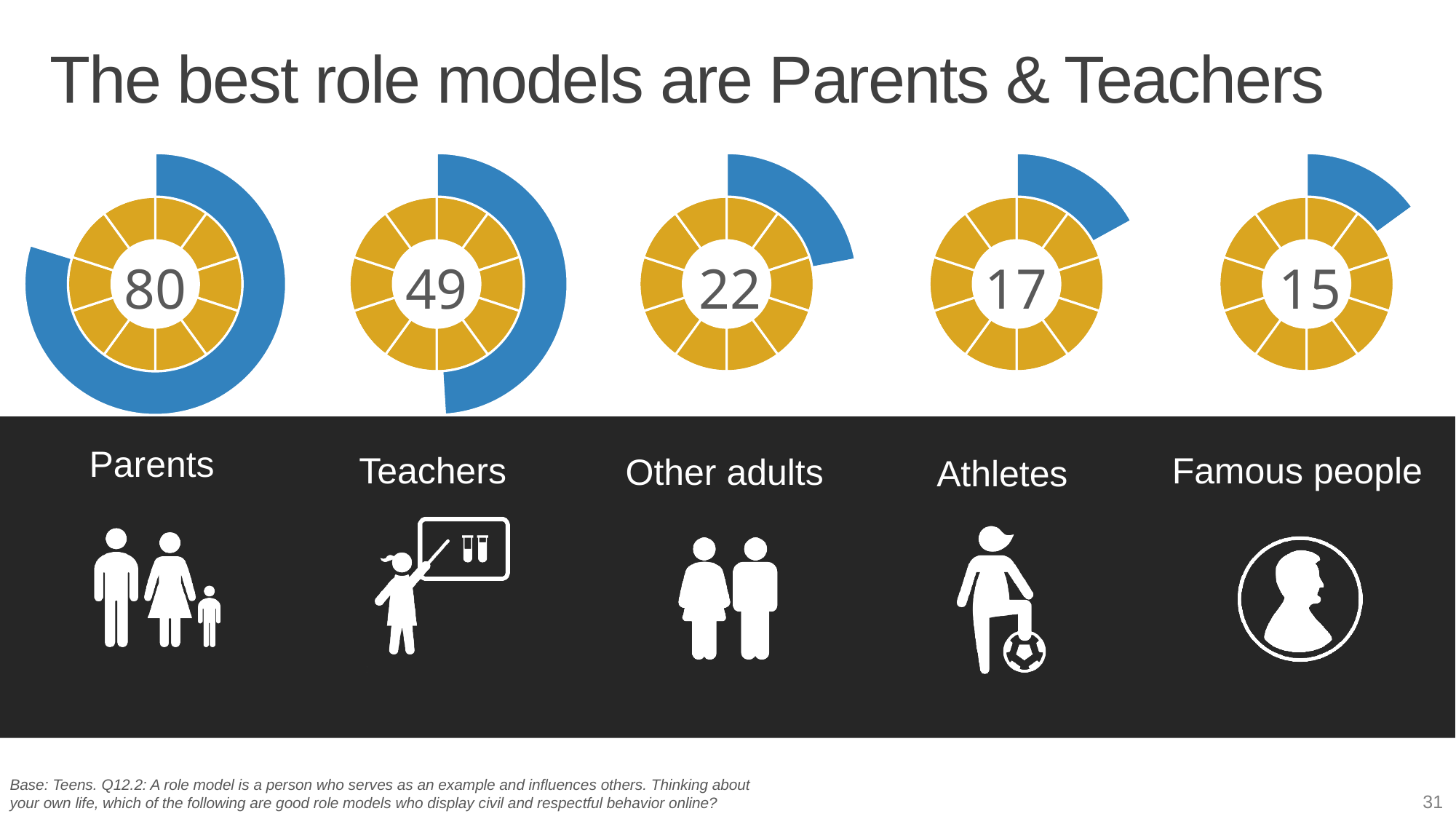
How many role model categories are shown on the slide? 5 What is the value shown for Famous people? 15 What is the value shown for Parents? 80 Which category has the lowest value? Famous people What is the value shown for Teachers? 49 What is the title of the slide? The best role models are Parents & Teachers What is the value shown for Athletes? 17 What is the difference between the values for Other adults and Athletes? 5 Which category has the highest value? Parents Which has a larger value, Teachers or Other adults? Teachers What is the difference between the values for Parents and Teachers? 31 What is the value shown for Other adults? 22